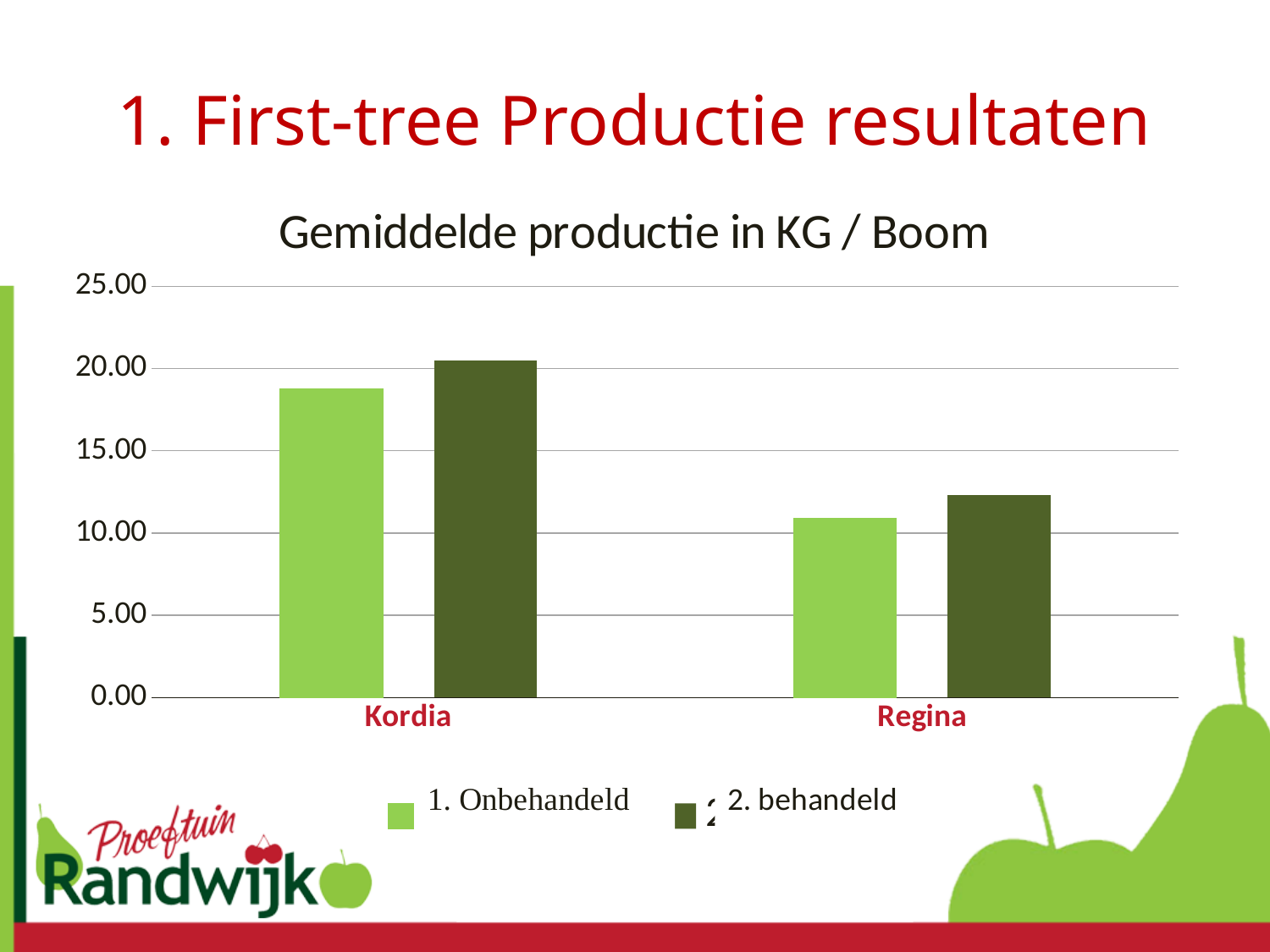
What is the title of the chart? Gemiddelde productie in KG / Boom Is the value for 1. Onbehandeld at Kordia greater or less than 15.00? greater Which category has the lowest bar in the chart? Regina How many series does the chart's legend list? 2 How many categories are shown on the x axis of the chart? 2 Is the value for 1. Onbehandeld at Regina greater or less than 10.00? greater Which series is shown in the darker green colour? 2. behandeld For Kordia, which series has the larger value: 1. Onbehandeld or 2. behandeld? 2. behandeld Which category has the highest bar in the chart? Kordia For Regina, which series has the larger value: 1. Onbehandeld or 2. behandeld? 2. behandeld What kind of chart is shown on the slide? bar chart Is the value for 2. behandeld at Regina greater or less than 15.00? less